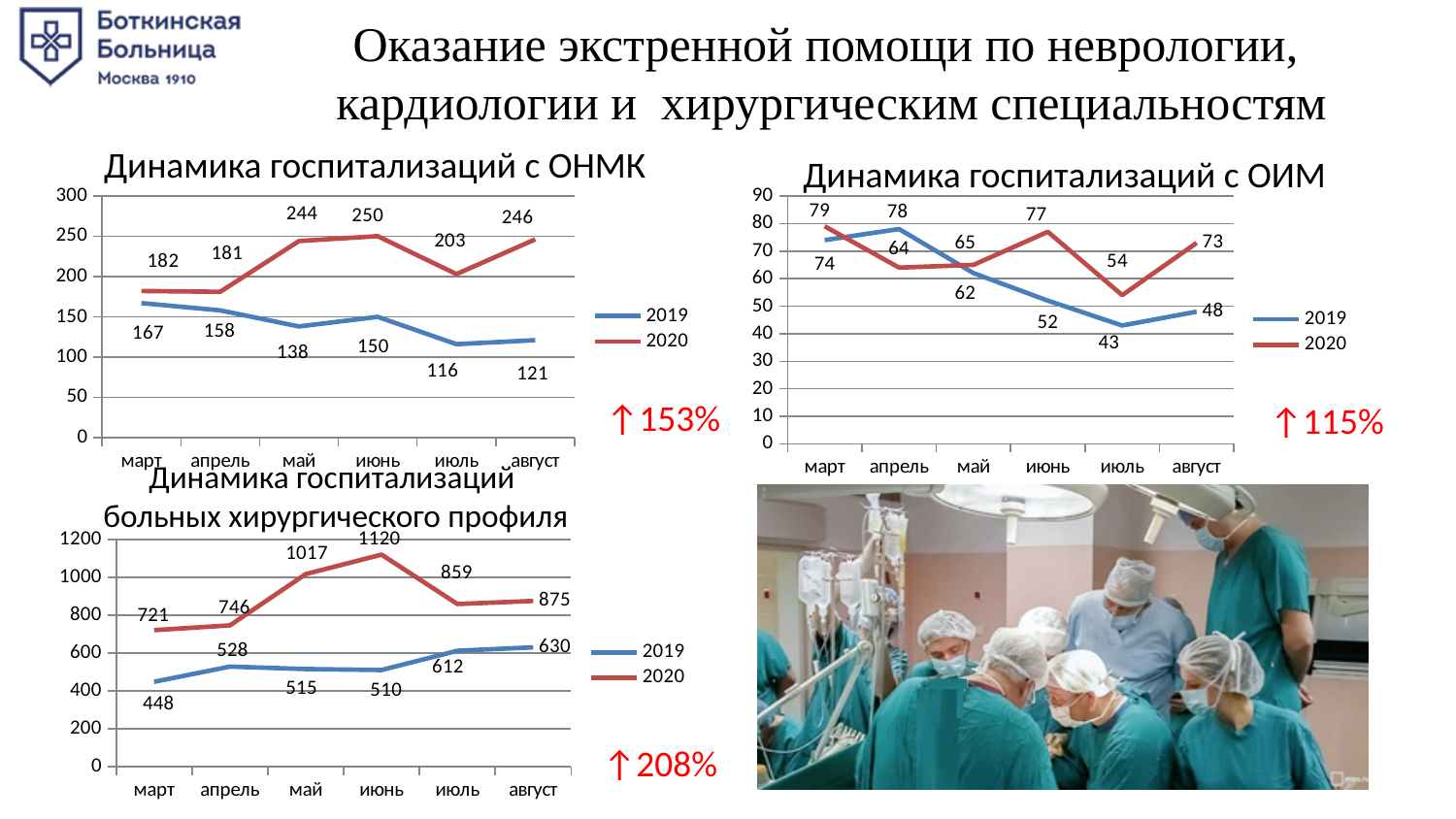
In the chart 'Динамика госпитализаций с ОНМК', what is the difference between the 2020 and 2019 values in август? 125 In the chart 'Динамика госпитализаций с ОНМК', which month has the lowest value for 2019? июль In the chart 'Динамика госпитализаций с ОНМК', what is the value for 2020 in июнь? 250 In the chart 'Динамика госпитализаций больных хирургического профиля', what is the difference between the 2020 and 2019 values in март? 273 In the chart 'Динамика госпитализаций с ОИМ', what is the value for 2020 in июнь? 77 In the chart 'Динамика госпитализаций с ОИМ', which is larger in апрель: the 2019 value or the 2020 value? 2019 How many months are shown on the x axis of the chart 'Динамика госпитализаций с ОНМК'? 6 What type of chart is 'Динамика госпитализаций с ОИМ'? line chart In the chart 'Динамика госпитализаций больных хирургического профиля', which month has the highest value for 2020? июнь In the chart 'Динамика госпитализаций с ОНМК', what is the value for 2019 in июль? 116 In the chart 'Динамика госпитализаций с ОИМ', which month has the lowest value for 2019? июль In the chart 'Динамика госпитализаций больных хирургического профиля', what is the value for 2020 in июнь? 1120